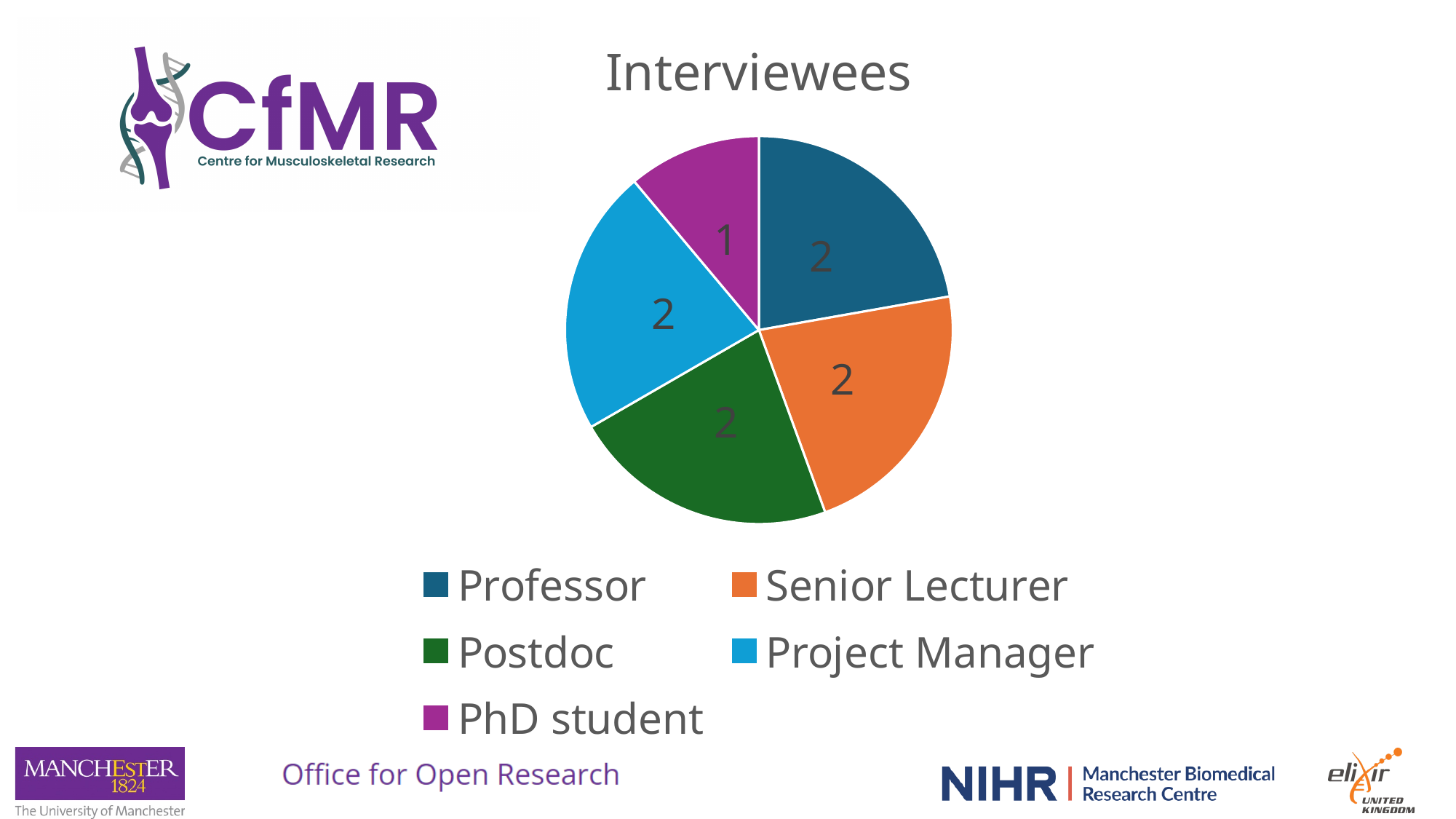
What is the difference between the number of Postdoc interviewees and PhD student interviewees? 1 How many interviewees were Professors? 2 How many interviewees were PhD students? 1 Which is larger, the number of Professor interviewees or PhD student interviewees? Professor How many interviewees were Project Managers? 2 What is the title of the chart? Interviewees Which category has the smallest slice of the pie? PhD student How many interviewees were Senior Lecturers? 2 How many categories does the pie chart have? 5 What is the total number of interviewees shown in the pie chart? 9 Which category is shown in green in the pie chart? Postdoc What kind of chart is shown on the slide? pie chart